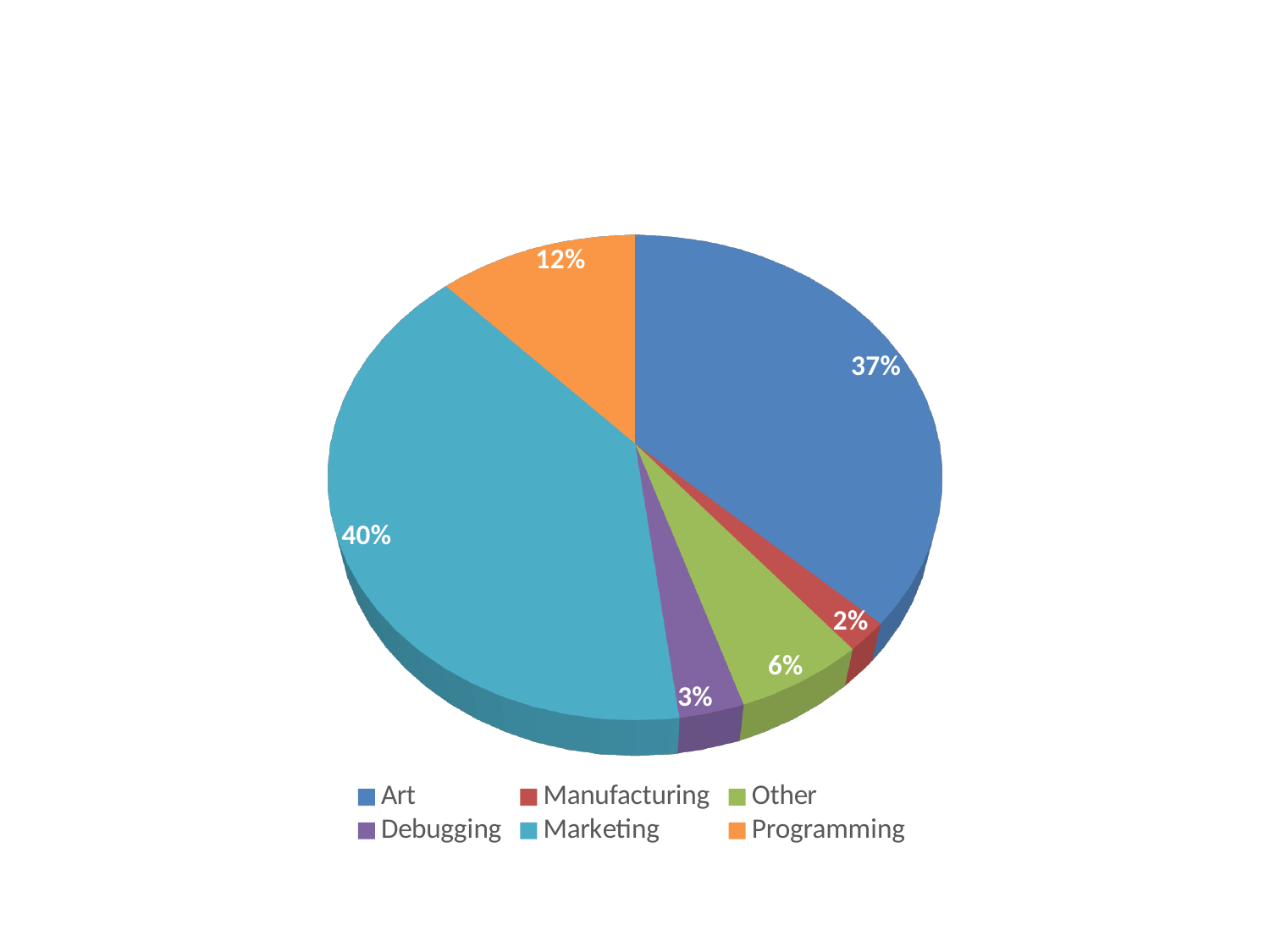
What is the difference in percentage points between Marketing and Art? 3 Which category has the smallest slice of the pie? Manufacturing What share of the pie does Manufacturing have? 2% Which category has the largest slice of the pie? Marketing What share of the pie does Programming have? 12% What share of the pie does Art have? 37% What kind of chart is shown on the slide? pie chart How many categories does the pie chart have? 6 What colour is the Marketing slice? teal Which is larger, the share for Other or the share for Programming? Programming